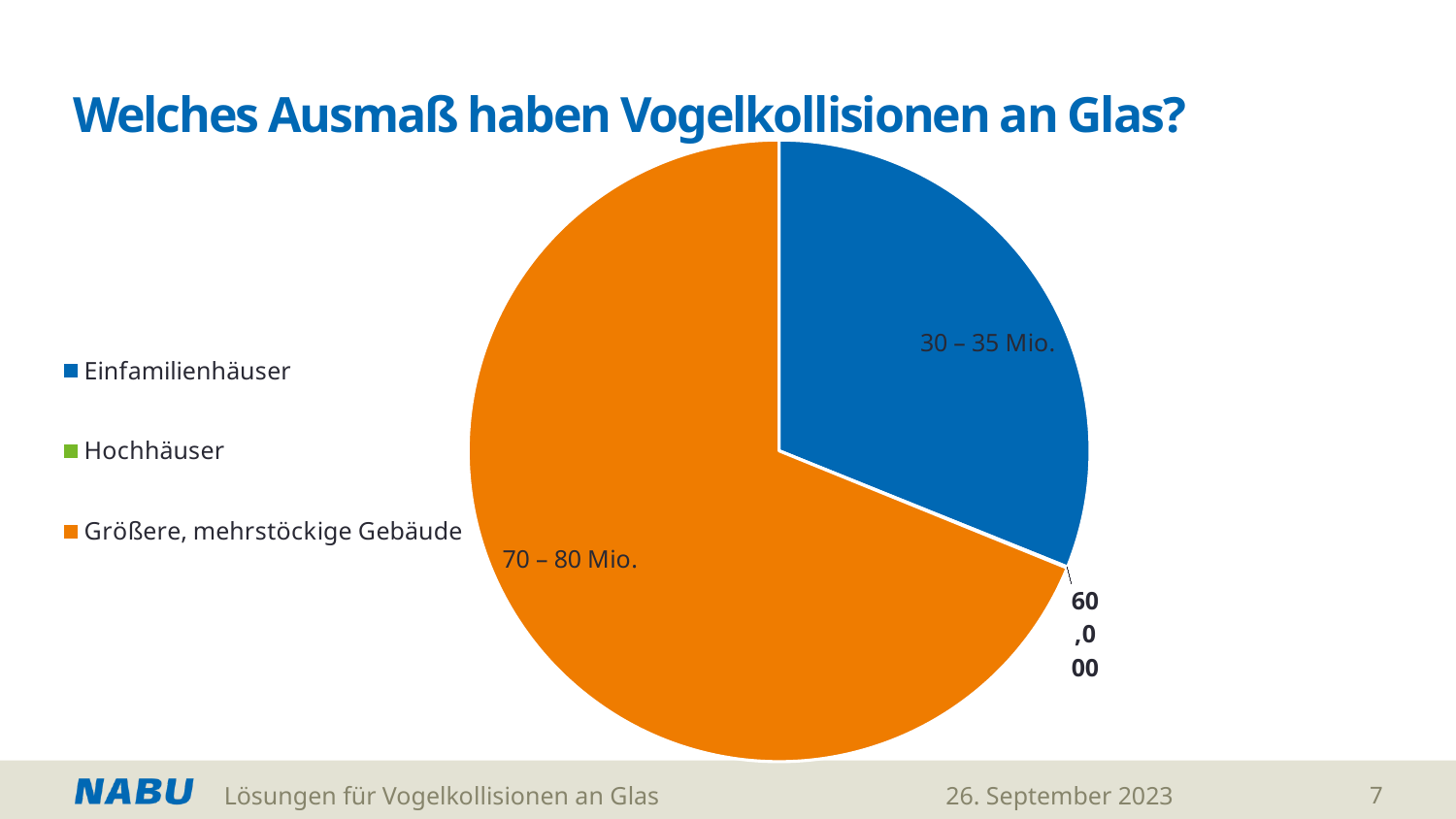
What value is labelled on the slice for Größere, mehrstöckige Gebäude? 70 – 80 Mio. Which category has the largest slice of the pie? Größere, mehrstöckige Gebäude What is the title of the slide containing the pie chart? Welches Ausmaß haben Vogelkollisionen an Glas? Which slice is larger, Einfamilienhäuser or Hochhäuser? Einfamilienhäuser Which slice is larger, Einfamilienhäuser or Größere, mehrstöckige Gebäude? Größere, mehrstöckige Gebäude How many categories does the legend of the pie chart list? 3 What value is labelled on the slice for Einfamilienhäuser? 30 – 35 Mio. What kind of chart is shown on the slide? pie chart Which category has the smallest slice of the pie? Hochhäuser What colour is the slice for Einfamilienhäuser? blue What value is labelled for the Hochhäuser slice? 60,000